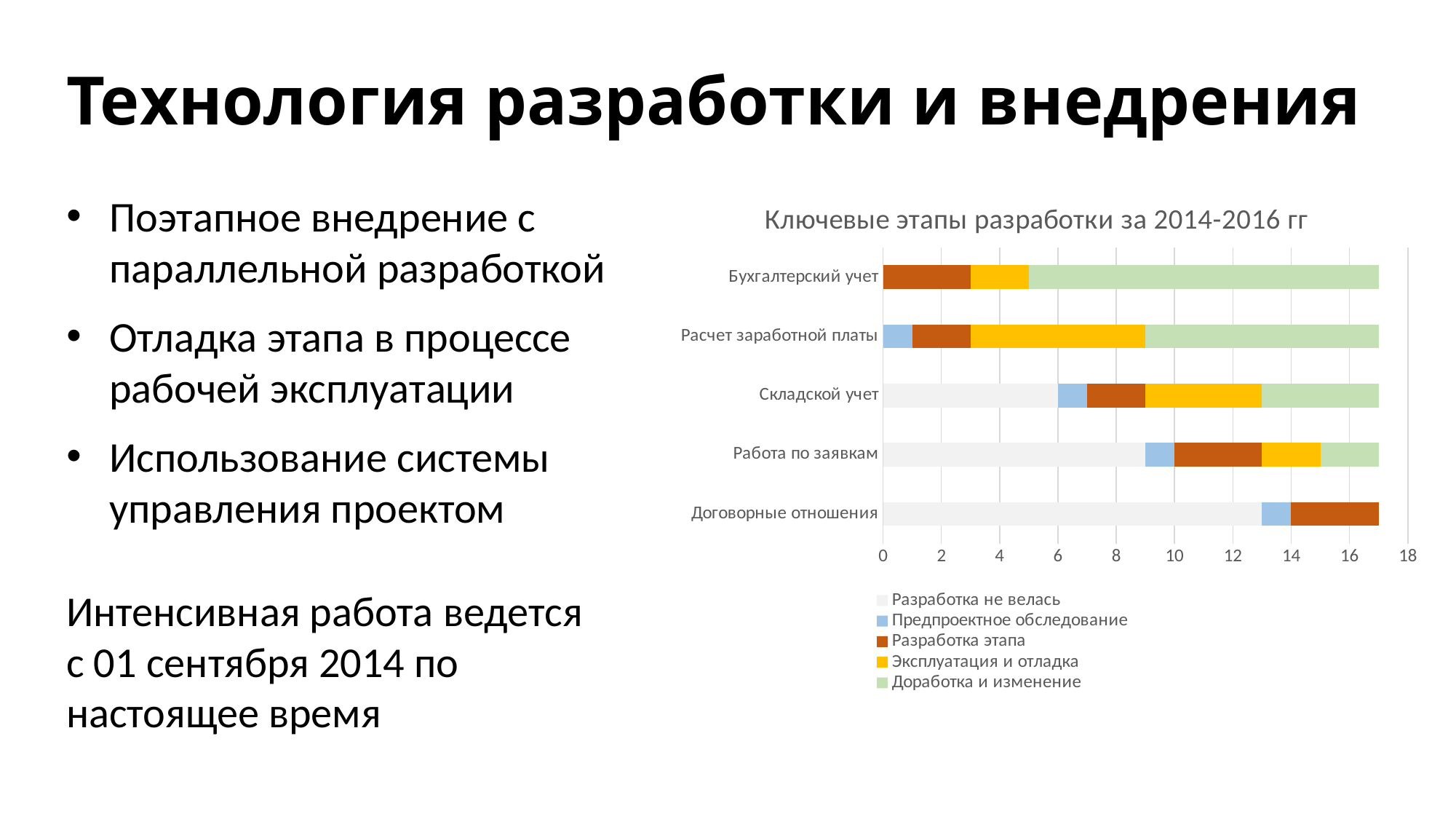
Which category has the longest "Доработка и изменение" segment? Бухгалтерский учет What is the title of the chart? Ключевые этапы разработки за 2014-2016 гг How many categories are shown on the chart's vertical axis? 5 Is the "Разработка не велась" segment for Договорные отношения greater or less than 12? greater Which category has the longest "Разработка не велась" segment? Договорные отношения Which has a longer "Доработка и изменение" segment: Бухгалтерский учет or Работа по заявкам? Бухгалтерский учет Which colour represents the series "Эксплуатация и отладка" in the legend? Yellow Which category has the longest "Эксплуатация и отладка" segment? Расчет заработной платы Which has a longer "Разработка не велась" segment: Складской учет or Работа по заявкам? Работа по заявкам How many series does the chart legend list? 5 What kind of chart is shown on the slide? Stacked bar chart Is the total length of the bar for Бухгалтерский учет greater or less than 16? greater